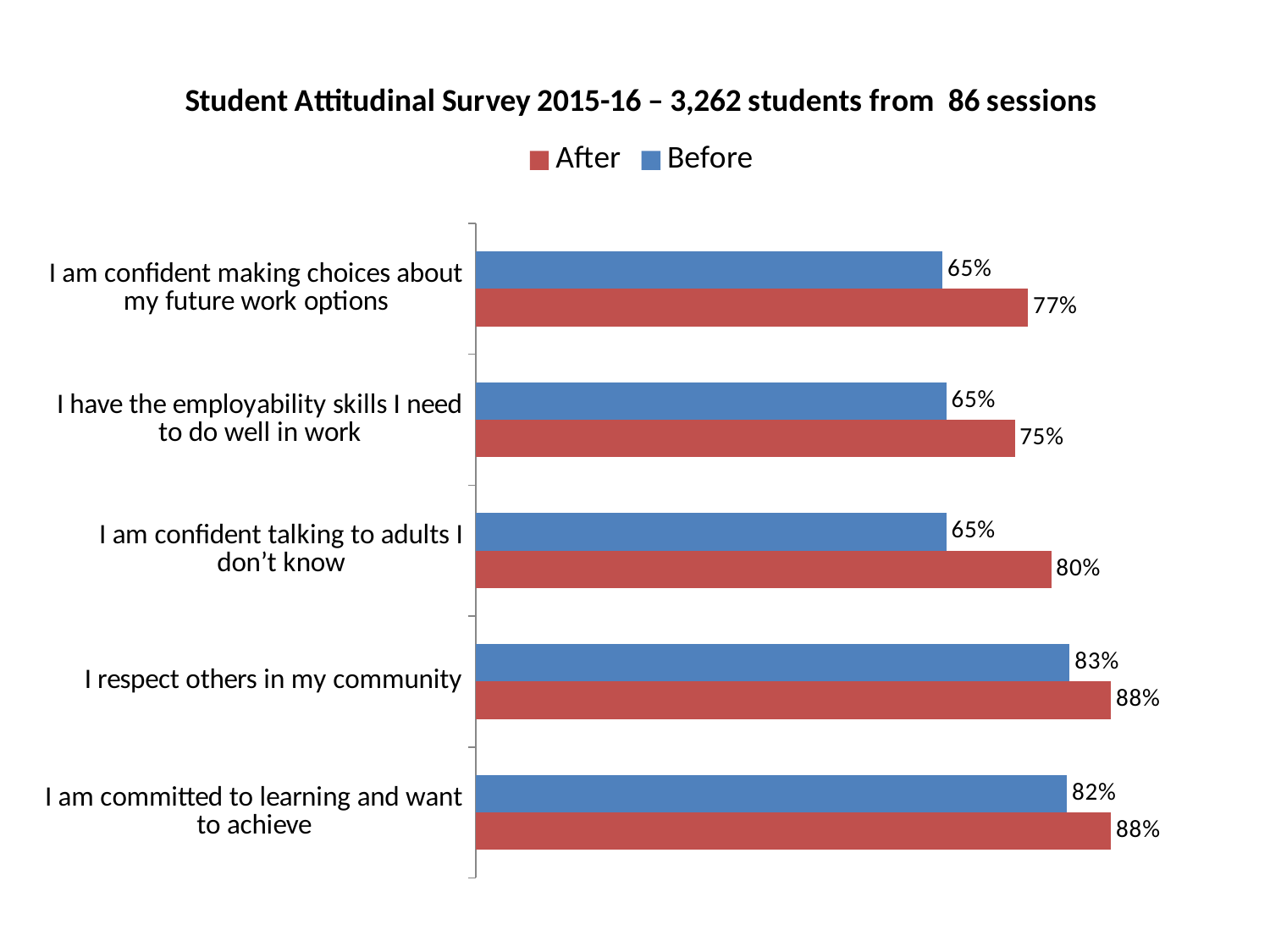
What is the 'After' value for 'I am confident talking to adults I don't know'? 80% How many series does the legend list? 2 What is the 'After' value for 'I have the employability skills I need to do well in work'? 75% What is the 'Before' value for 'I respect others in my community'? 83% What kind of chart is shown on the slide? Bar chart What is the difference between the 'After' and 'Before' values for 'I am confident making choices about my future work options'? 12% What is the difference between the 'After' and 'Before' values for 'I am confident talking to adults I don't know'? 15% How many categories are shown on the chart? 5 What is the 'Before' value for 'I am committed to learning and want to achieve'? 82% Which is larger for 'I respect others in my community': the 'Before' value or the 'After' value? After Which category has the lowest 'After' value? I have the employability skills I need to do well in work What is the title of the chart? Student Attitudinal Survey 2015-16 – 3,262 students from 86 sessions